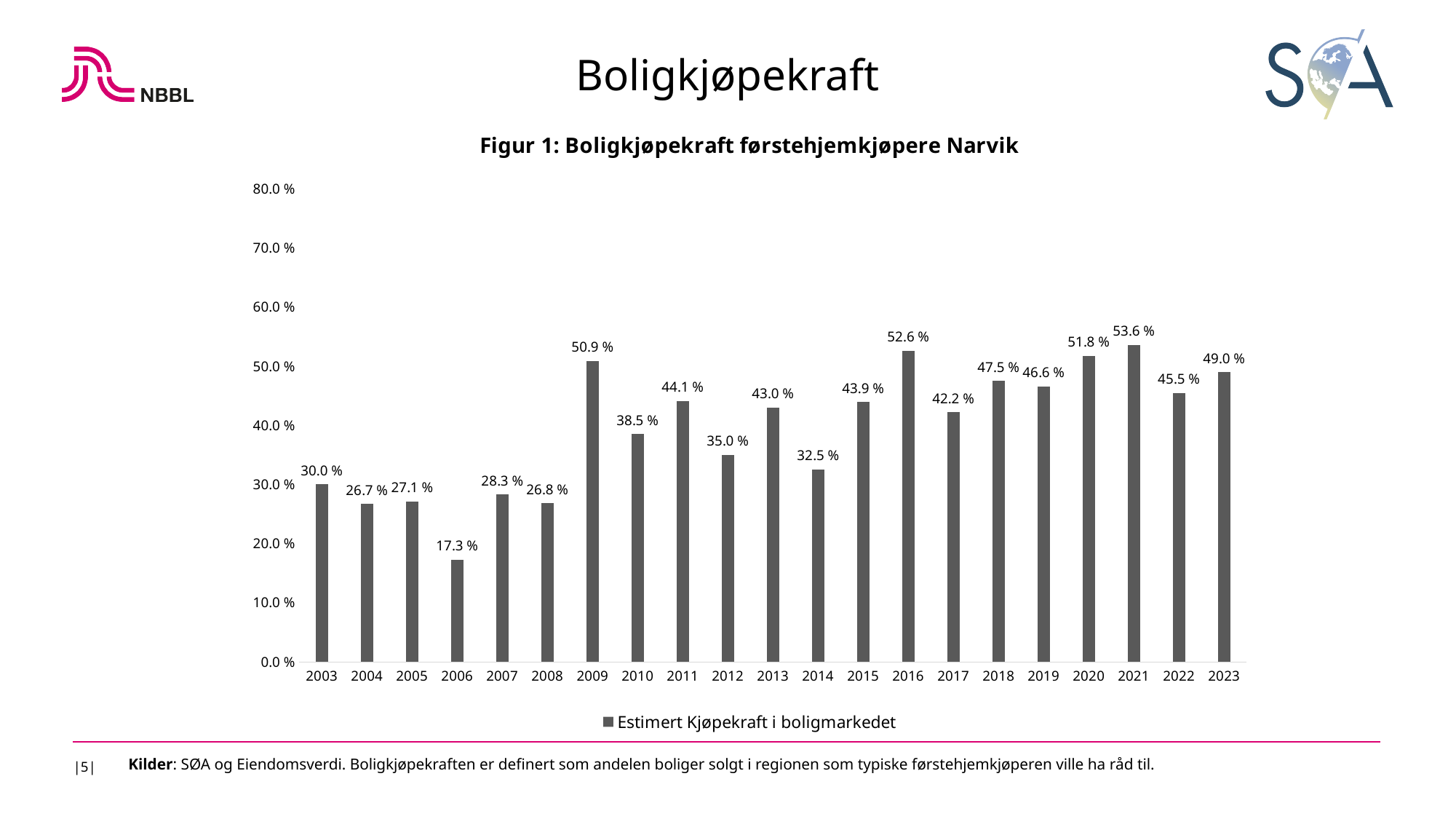
How many years are shown on the x axis? 21 Which year has the highest value? 2021 What is the value for 2023? 49.0 % What is the title of the chart? Figur 1: Boligkjøpekraft førstehjemkjøpere Narvik What kind of chart is shown? bar chart What is the value for 2014? 32.5 % What is the difference between the values for 2021 and 2006? 36.3 % Is the value for 2010 greater or less than 40.0 %? less Which is larger, the value for 2016 or the value for 2020? 2016 What is the value for 2009? 50.9 % Which year has the lowest value? 2006 How many series does the legend list? 1